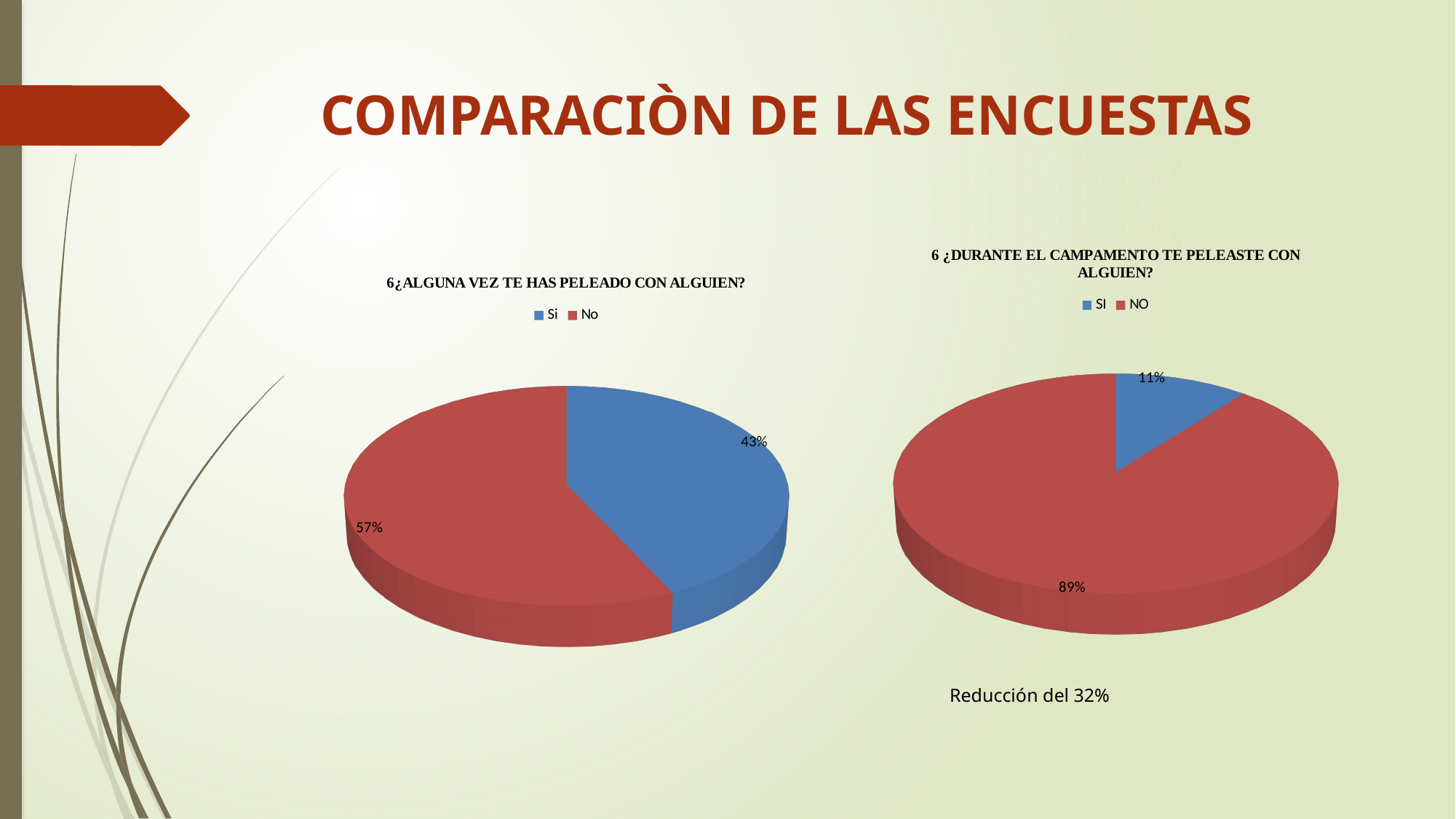
In the right chart, which slice is the smallest? SI In the right chart, what is the difference between the "NO" share and the "SI" share? 78% In the right chart titled "6 ¿DURANTE EL CAMPAMENTO TE PELEASTE CON ALGUIEN?", what share of the pie is "SI"? 11% What kind of chart is the left chart? Pie chart In the left chart titled "6¿ALGUNA VEZ TE HAS PELEADO CON ALGUIEN?", what share of the pie is "Si"? 43% In the left chart, which slice is larger, "Si" or "No"? No In the right chart, which slice is the largest? NO In the left chart, what colour is the "Si" slice? Blue In the left chart, what is the difference between the "No" share and the "Si" share? 14% In the left chart titled "6¿ALGUNA VEZ TE HAS PELEADO CON ALGUIEN?", what share of the pie is "No"? 57% How many slices does the right chart have? 2